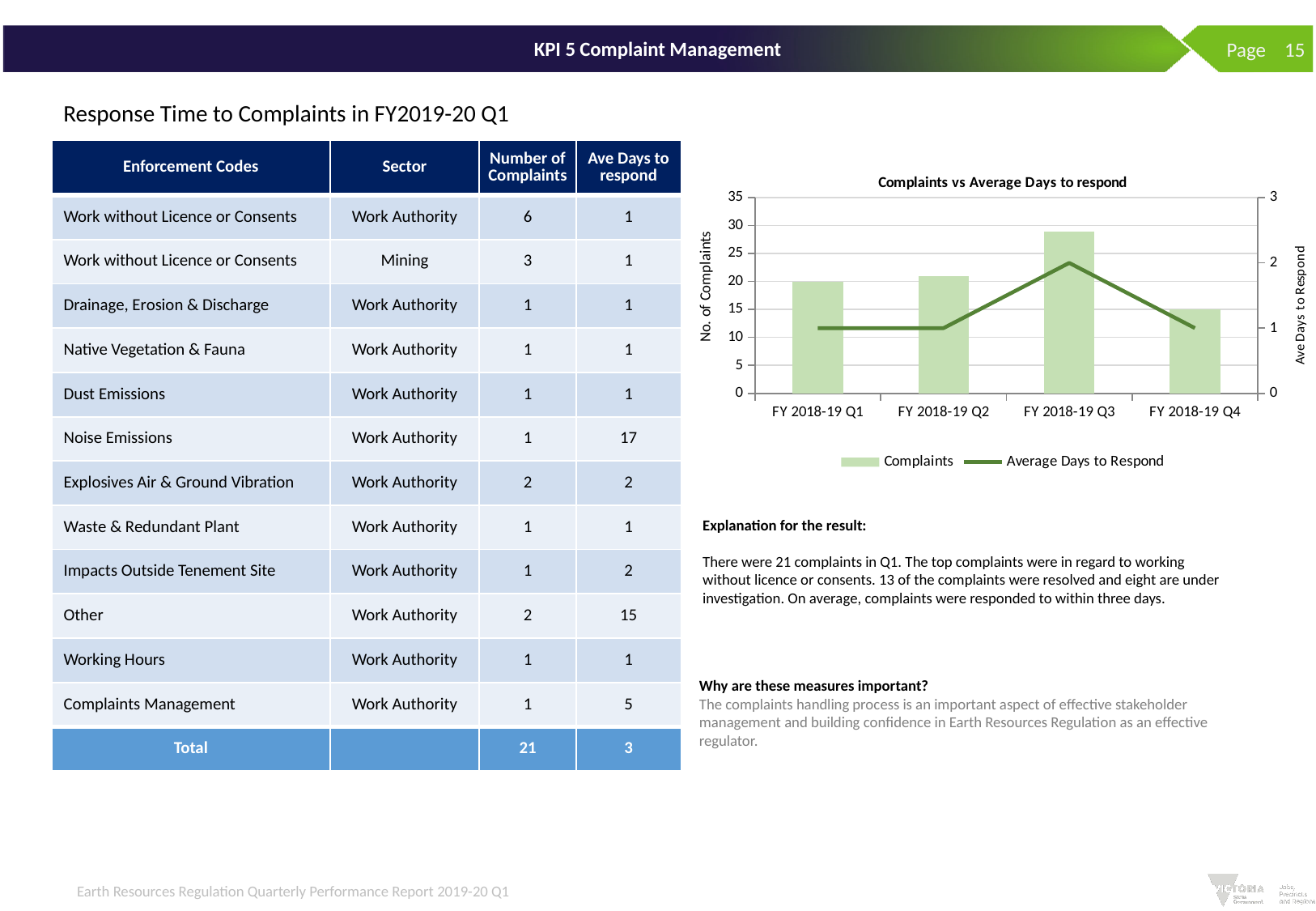
What is the title of the chart? Complaints vs Average Days to respond How many series does the chart legend list? 2 What is the label on the left vertical axis of the chart? No. of Complaints How many quarters are shown on the x axis of the chart? 4 Is the number of complaints for FY 2018-19 Q4 greater or less than 20? less What kind of chart is shown on the slide? A combined bar and line chart Which quarter has the highest average days to respond? FY 2018-19 Q3 Which quarter has the lowest number of complaints? FY 2018-19 Q4 Which quarter has more complaints, FY 2018-19 Q3 or FY 2018-19 Q4? FY 2018-19 Q3 Which quarter has the highest number of complaints? FY 2018-19 Q3 Is the number of complaints for FY 2018-19 Q3 greater or less than 25? greater Is the number of complaints for FY 2018-19 Q1 greater or less than 25? less